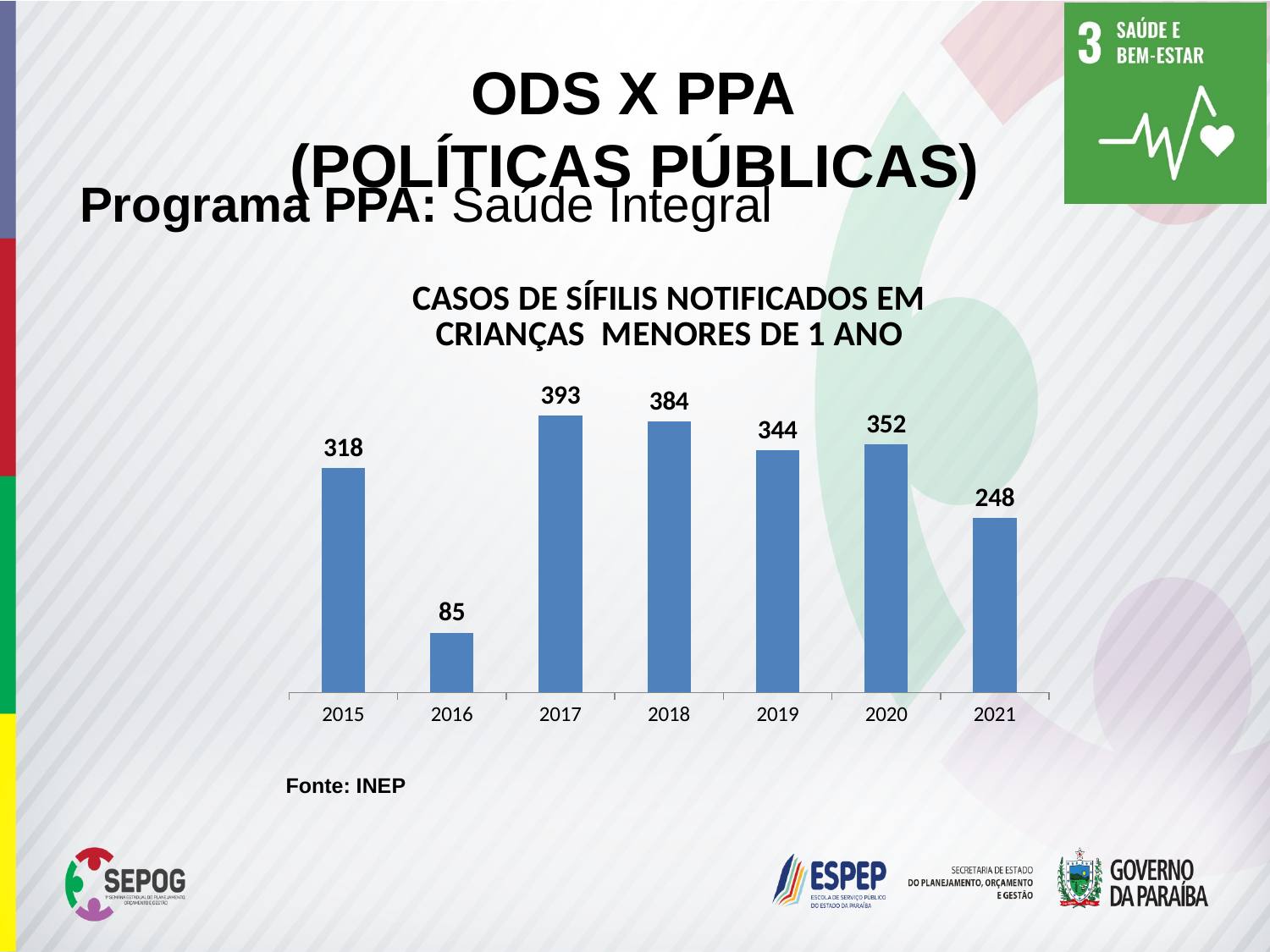
How many years are shown on the x axis? 7 What is the number of syphilis cases notified in children under 1 year in 2017? 393 What is the title of the chart? CASOS DE SÍFILIS NOTIFICADOS EM CRIANÇAS MENORES DE 1 ANO What is the difference between the values for 2017 and 2018? 9 What is the difference between the values for 2015 and 2016? 233 Which year has the highest number of cases? 2017 What value is shown for 2021? 248 What kind of chart is shown on the slide? Bar chart Which is larger, the value for 2019 or the value for 2020? 2020 What value is shown for 2016? 85 Which year has the lowest number of cases? 2016